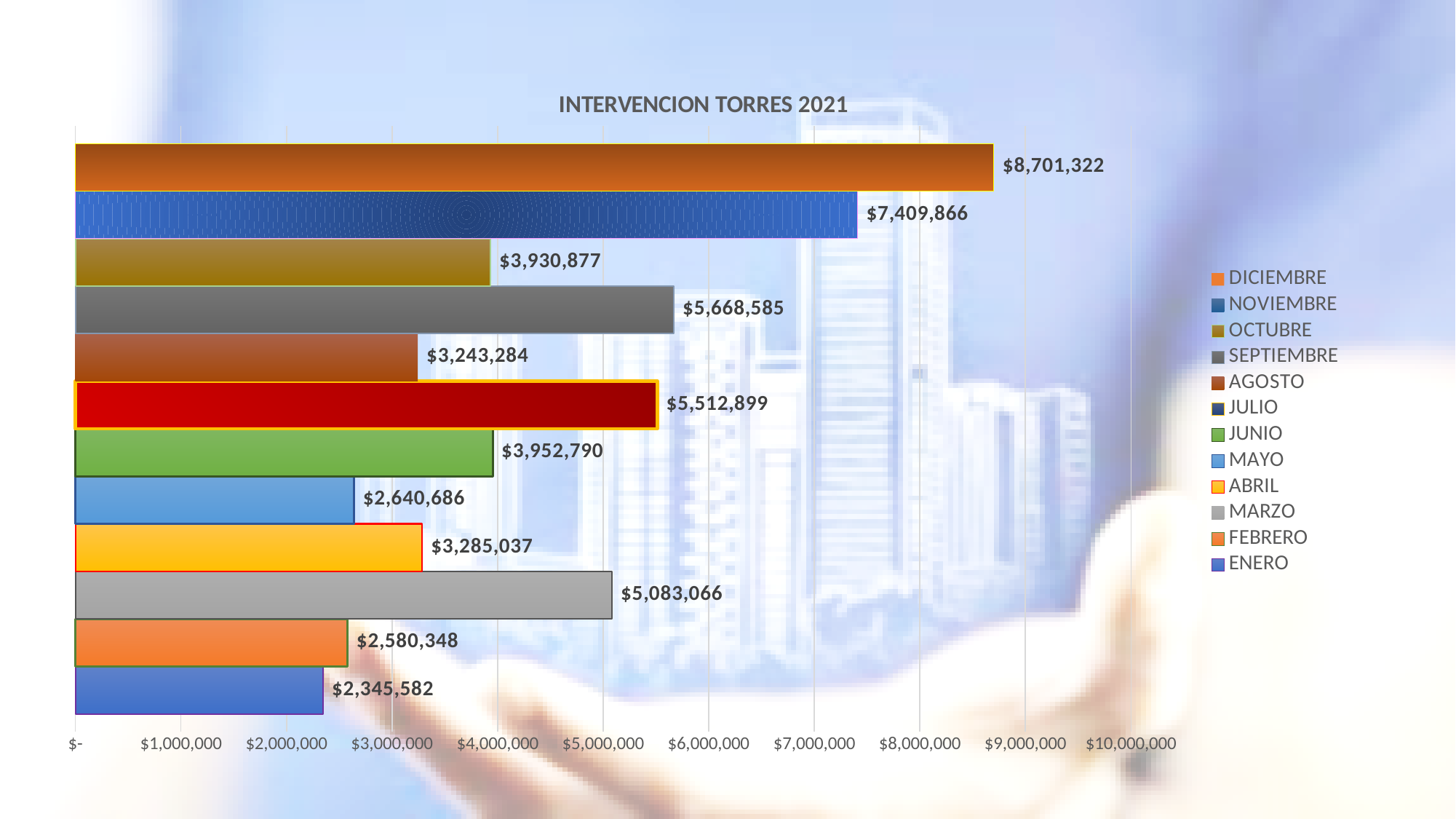
What is the title of the chart? INTERVENCION TORRES 2021 What is the value for ENERO? $2,345,582 Which month has the lowest value in the chart? ENERO How many entries does the legend list? 12 What is the value for SEPTIEMBRE? $5,668,585 Which is larger, the value for SEPTIEMBRE or the value for MARZO? SEPTIEMBRE What is the value for ABRIL? $3,285,037 What kind of chart is shown on the slide? bar chart What is the difference between the values for DICIEMBRE and NOVIEMBRE? $1,291,456 Which month has the highest value in the chart? DICIEMBRE Is the value for NOVIEMBRE greater or less than $7,000,000? greater What is the value for MARZO? $5,083,066